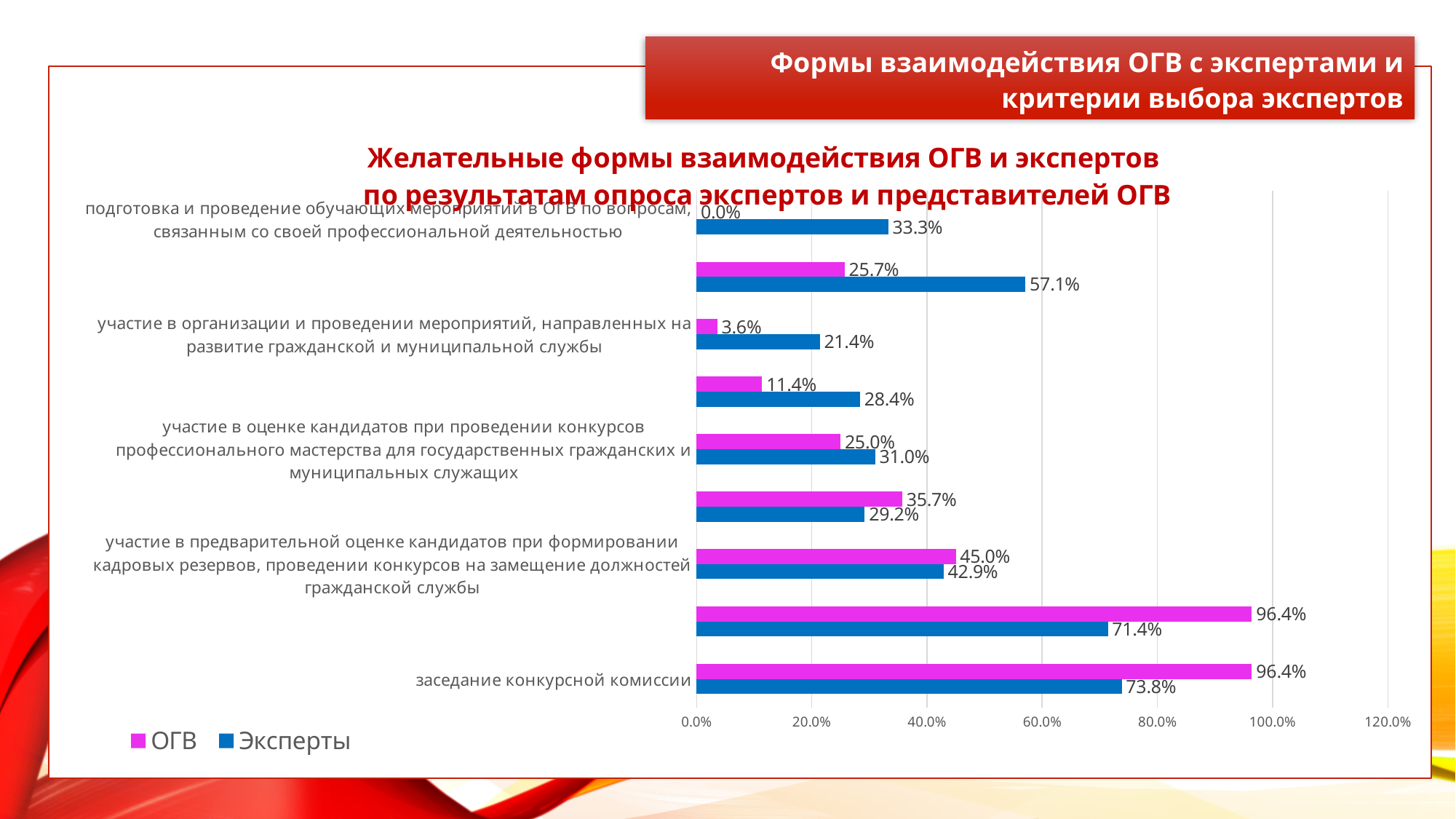
What is the value for ОГВ for "подготовка и проведение обучающих мероприятий в ОГВ по вопросам, связанным со своей профессиональной деятельностью"? 0.0% What are the two series named in the legend? ОГВ and Эксперты What is the value for Эксперты for "подготовка и проведение обучающих мероприятий в ОГВ по вопросам, связанным со своей профессиональной деятельностью"? 33.3% What is the value for ОГВ for "заседание конкурсной комиссии"? 96.4% How many series does the legend list? 2 How many groups of bars are plotted in the chart? 9 What is the difference between the ОГВ and Эксперты values for "заседание конкурсной комиссии"? 22.6% For "заседание конкурсной комиссии", which series has the larger value, ОГВ or Эксперты? ОГВ What is the lowest value shown for the ОГВ series? 0.0% What type of chart is shown on the slide? bar chart What is the highest value shown for the Эксперты series? 73.8% What is the value for Эксперты for "заседание конкурсной комиссии"? 73.8%